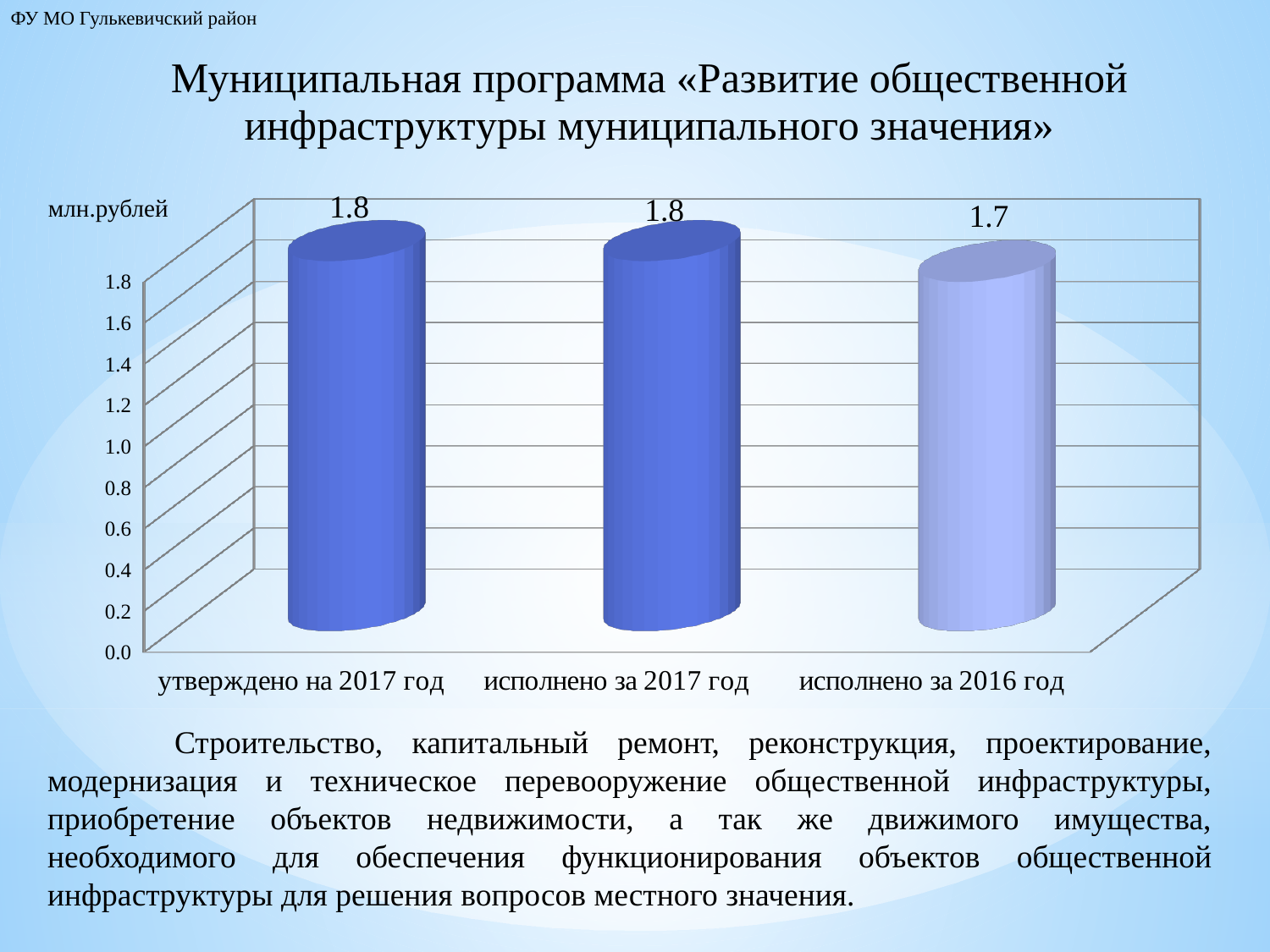
Is the value for «исполнено за 2016 год» greater or less than 1.0? greater Do the values rise or fall from «исполнено за 2017 год» to «исполнено за 2016 год»? fall Which is larger: the value for «исполнено за 2017 год» or the value for «исполнено за 2016 год»? исполнено за 2017 год What is the value for «утверждено на 2017 год»? 1.8 What kind of chart is shown on the slide? bar chart What unit is indicated for the values in the chart? млн.рублей Which category has the lowest value? исполнено за 2016 год What is the value for «исполнено за 2017 год»? 1.8 What is the value for «исполнено за 2016 год»? 1.7 How many categories are shown in the chart? 3 What is the difference between the value for «утверждено на 2017 год» and the value for «исполнено за 2016 год»? 0.1 What is the title of the slide containing the chart? Муниципальная программа «Развитие общественной инфраструктуры муниципального значения»